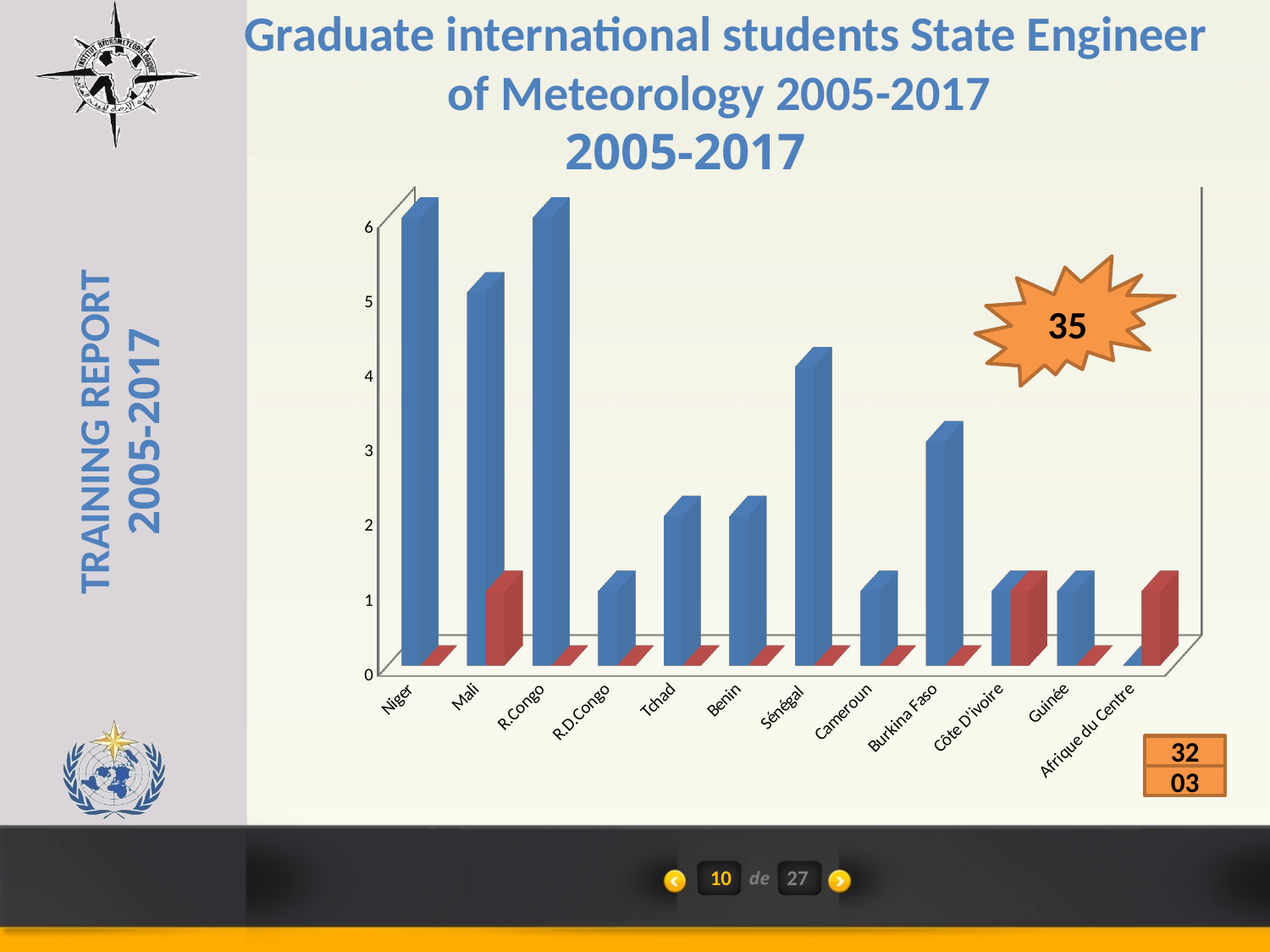
What is the title of the chart on the slide? Graduate international students State Engineer of Meteorology 2005-2017 Which has the larger blue bar, Tchad or R.D.Congo? Tchad Is the blue bar for Burkina Faso greater or less than 2? greater What number is shown in the orange starburst on the chart? 35 Is the blue bar for Cameroun greater or less than 2? less Which country has the lowest blue bar in the chart? Afrique du Centre How many countries are shown on the x axis of the chart? 12 How many data series (bar colours) are plotted in the chart? 2 What kind of chart is shown on the slide? bar chart Which has the larger blue bar, Mali or Sénégal? Mali Is the blue bar for Sénégal greater or less than 3? greater